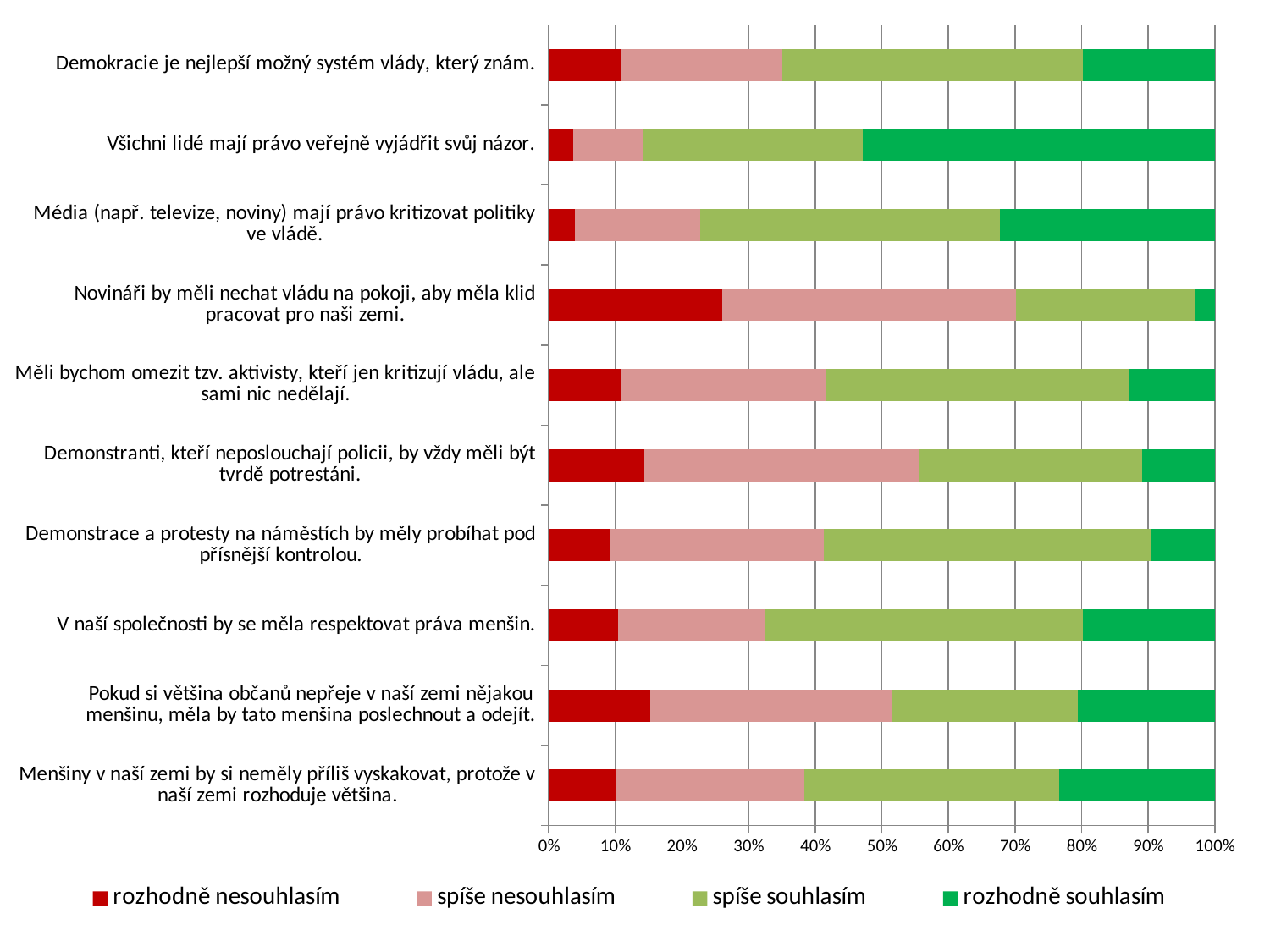
What kind of chart is shown on the slide? Stacked bar chart Which statement has the largest 'rozhodně souhlasím' share? Všichni lidé mají právo veřejně vyjádřit svůj názor. What is the range of the horizontal axis? 0% to 100% Which has the larger 'rozhodně nesouhlasím' share: 'Demonstranti, kteří neposlouchají policii, by vždy měli být tvrdě potrestáni.' or 'Demonstrace a protesty na náměstích by měly probíhat pod přísnější kontrolou.'? Demonstranti, kteří neposlouchají policii, by vždy měli být tvrdě potrestáni. How many series does the legend list? 4 Is the 'rozhodně souhlasím' share for 'Všichni lidé mají právo veřejně vyjádřit svůj názor.' greater or less than 50%? greater Which statement has the smallest 'rozhodně souhlasím' share? Novináři by měli nechat vládu na pokoji, aby měla klid pracovat pro naši zemi. Is the 'rozhodně nesouhlasím' share for 'Novináři by měli nechat vládu na pokoji, aby měla klid pracovat pro naši zemi.' greater or less than 20%? greater What colour represents 'rozhodně nesouhlasím' in the legend? Red Which has the larger 'rozhodně souhlasím' share: 'Média (např. televize, noviny) mají právo kritizovat politiky ve vládě.' or 'Demokracie je nejlepší možný systém vlády, který znám.'? Média (např. televize, noviny) mají právo kritizovat politiky ve vládě. Which statement has the largest 'rozhodně nesouhlasím' share? Novináři by měli nechat vládu na pokoji, aby měla klid pracovat pro naši zemi. How many statements (categories) are plotted on the chart? 10